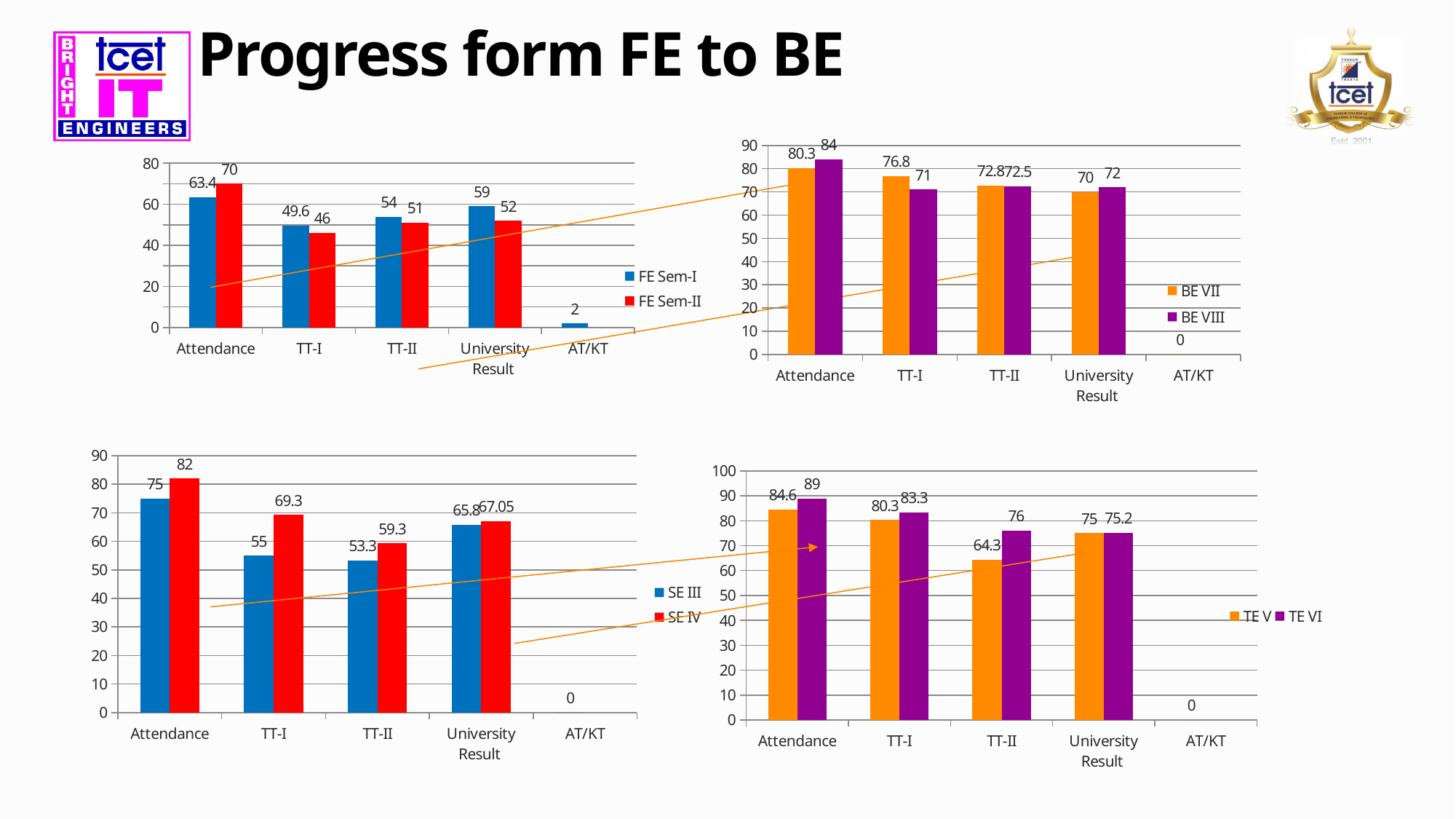
In the bottom-right chart, what is the TE VI value for TT-II? 76 How many series does the legend of the bottom-right chart list? 2 In the bottom-right chart, what is the difference between the TE VI and TE V values for Attendance? 4.4 In the top-right chart, what is the BE VIII value for Attendance? 84 In the bottom-left chart, which is larger for TT-II: SE III or SE IV? SE IV In the bottom-left chart, what is the SE IV value for University Result? 67.05 In the top-right chart, what is the BE VII value for AT/KT? 0 In the top-left chart, what is the difference between the FE Sem-II and FE Sem-I values for Attendance? 6.6 In the top-left chart, what is the FE Sem-I value for Attendance? 63.4 In the bottom-left chart, what is the SE IV value for TT-I? 69.3 In the top-left chart, what is the FE Sem-II value for University Result? 52 In the top-right chart, which category has the highest BE VII value? Attendance